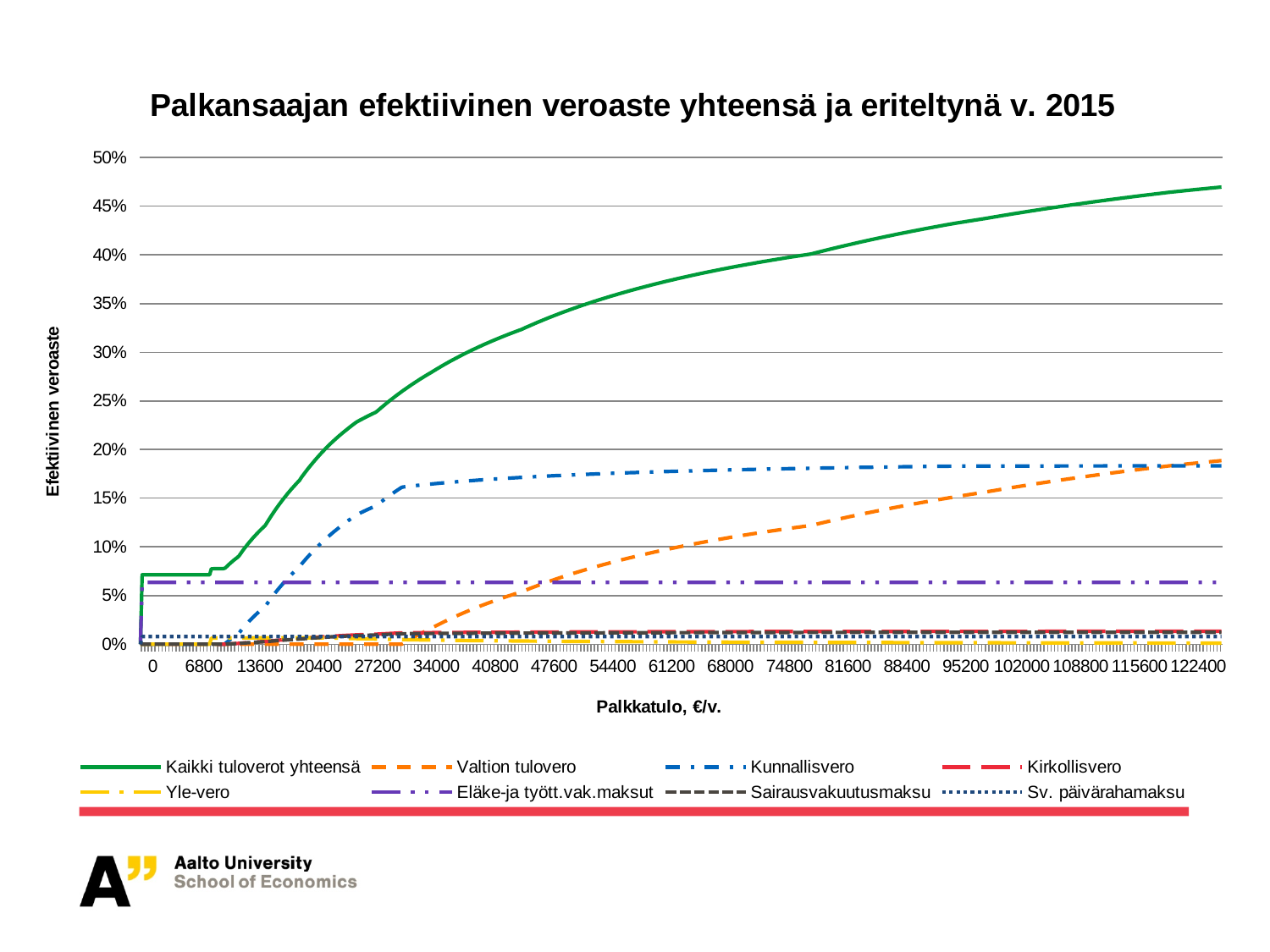
What is the label of the x axis? Palkkatulo, €/v. Is the value of Kunnallisvero at 122400 greater or less than 15%? greater Is the value of Valtion tulovero at 27200 greater or less than 5%? less Does the Kaikki tuloverot yhteensä line rise or fall as Palkkatulo increases? rise What is the title of the chart? Palkansaajan efektiivinen veroaste yhteensä ja eriteltynä v. 2015 Which series has the highest value at 122400? Kaikki tuloverot yhteensä What kind of chart is shown on the slide? line chart Is the value of Kaikki tuloverot yhteensä at 122400 greater or less than 45%? greater Which series has the lowest value at 122400? Yle-vero At 40800, which is larger: Kunnallisvero or Valtion tulovero? Kunnallisvero How many series does the legend list? 8